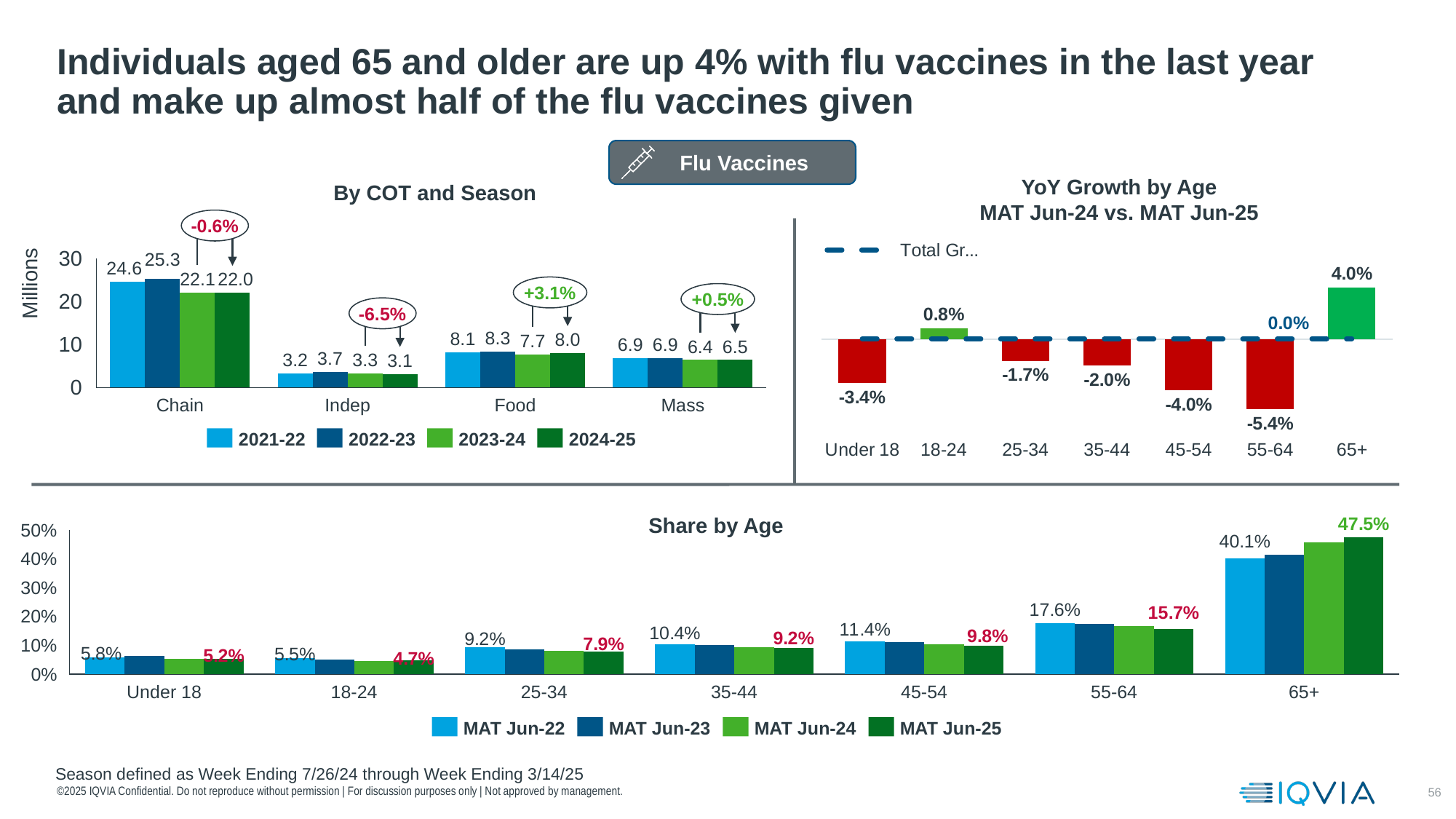
In the 'By COT and Season' chart, what is the value for Food in 2024-25? 8.0 In the 'By COT and Season' chart, how many series does the legend list? 4 In the 'YoY Growth by Age' chart, how many age groups are shown? 7 In the 'YoY Growth by Age' chart, which age group has the highest growth? 65+ In the 'Share by Age' chart, what is the difference between the MAT Jun-22 and MAT Jun-25 shares for 55-64? 1.9% In the 'Share by Age' chart, what is the MAT Jun-25 share for 65+? 47.5% In the 'Share by Age' chart, is the MAT Jun-22 share for 45-54 larger or smaller than the MAT Jun-25 share for 45-54? larger In the 'By COT and Season' chart, what is the value for Chain in 2022-23? 25.3 What kind of chart is the 'Share by Age' chart? bar chart In the 'By COT and Season' chart, which channel has the lowest values? Indep In the 'YoY Growth by Age' chart, what is the value for 55-64? -5.4% In the 'By COT and Season' chart, what is the difference between the Chain values for 2021-22 and 2024-25? 2.6